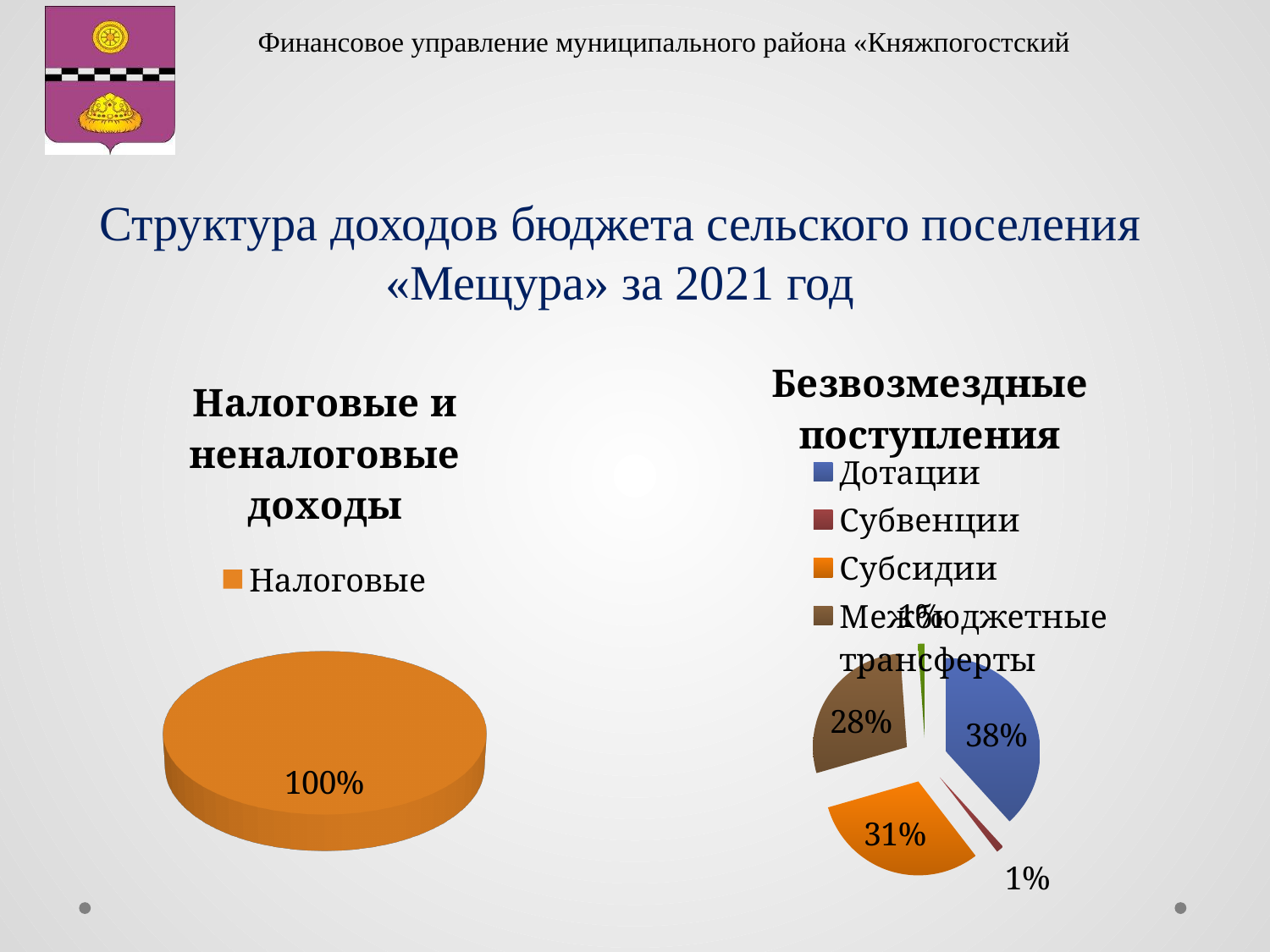
In the right chart «Безвозмездные поступления», what share is shown for Межбюджетные трансферты? 28% How many entries does the legend of the right chart «Безвозмездные поступления» list? 4 In the right chart «Безвозмездные поступления», which is larger: Субсидии or Межбюджетные трансферты? Субсидии In the right chart «Безвозмездные поступления», which legend category has the largest share? Дотации In the right chart «Безвозмездные поступления», what share is shown for Субвенции? 1% In the right chart «Безвозмездные поступления», by how many percentage points does Дотации exceed Субсидии? 7 percentage points How many entries does the legend of the left chart «Налоговые и неналоговые доходы» list? 1 What kind of chart is the left chart titled «Налоговые и неналоговые доходы»? pie chart In the right chart «Безвозмездные поступления», what share is shown for Дотации? 38% What kind of chart is the right chart titled «Безвозмездные поступления»? pie chart In the left chart «Налоговые и неналоговые доходы», what share is shown for Налоговые? 100%